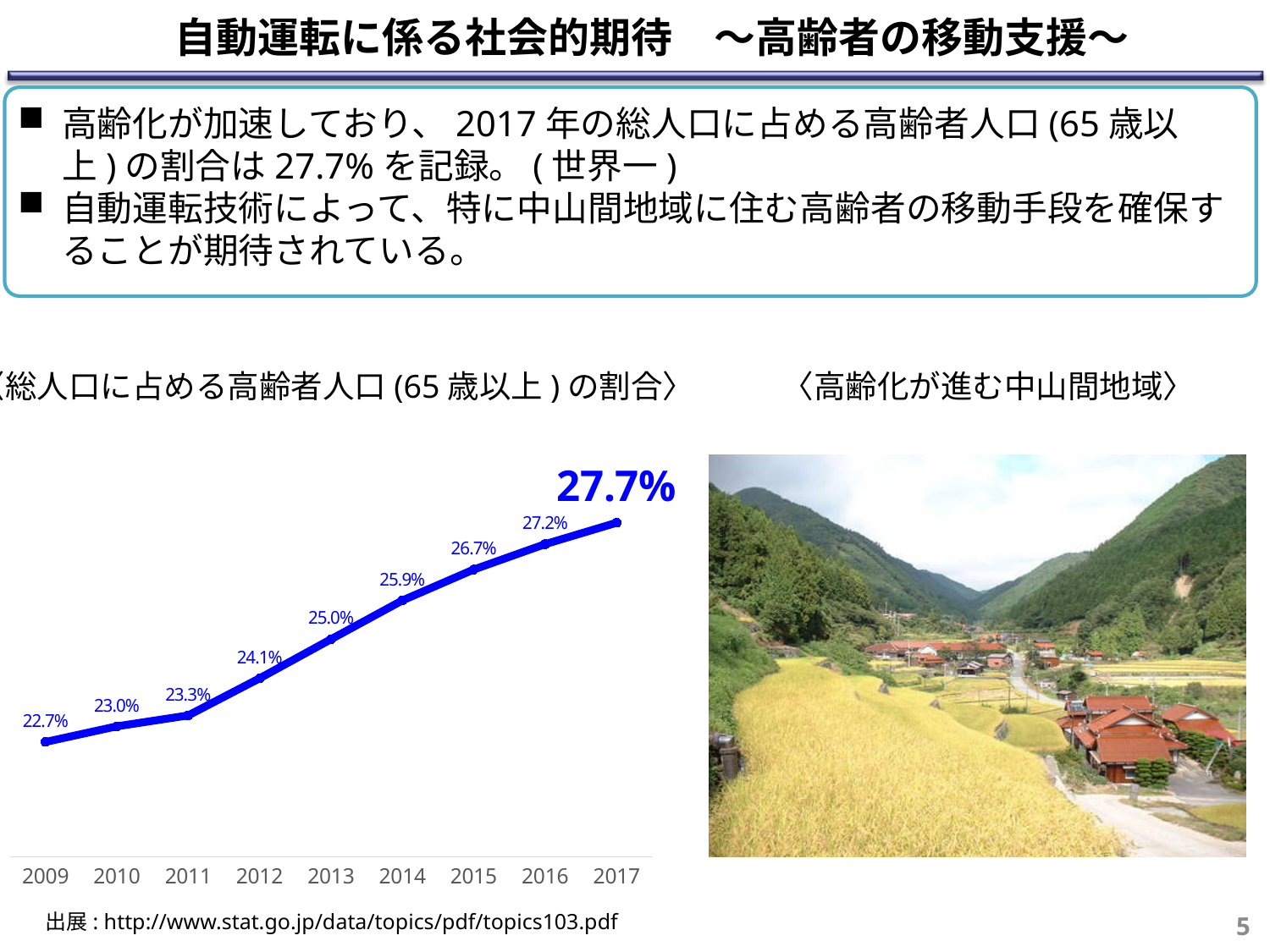
What is the value for 2009 in the line chart? 22.7% Which is larger in the line chart, the value for 2014 or the value for 2012? 2014 Which year has the lowest value in the line chart? 2009 What is the difference between the values for 2017 and 2009 in the line chart? 5.0% How many years are plotted in the line chart? 9 What is the value for 2017 in the line chart? 27.7% Which year has the highest value in the line chart? 2017 What is the value for 2015 in the line chart? 26.7% What is the difference between the values for 2012 and 2011 in the line chart? 0.8% What kind of chart is shown on the slide? line chart Do the values in the line chart rise or fall from 2009 to 2017? rise What is the value for 2013 in the line chart? 25.0%